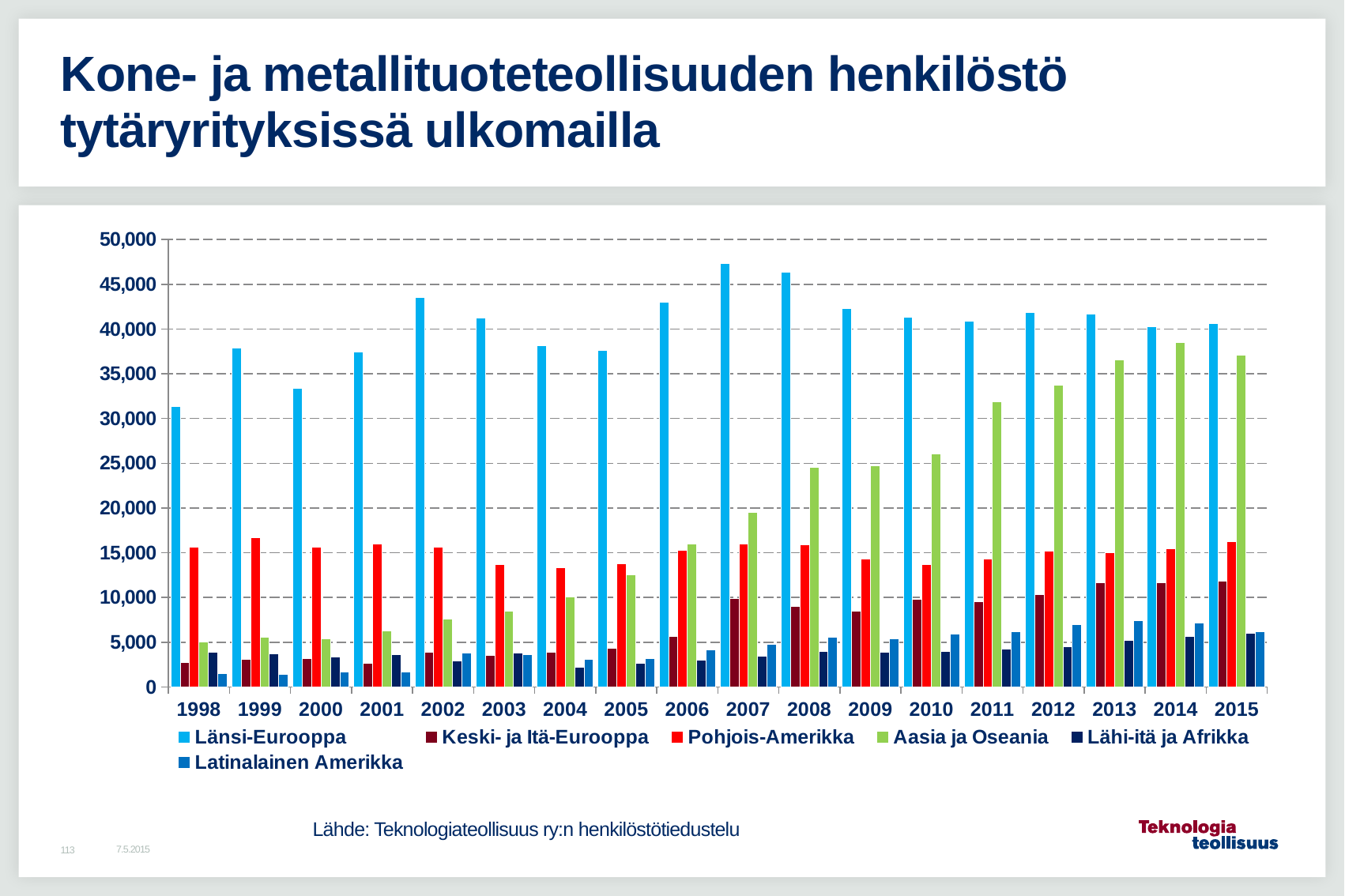
How many series does the legend list? 6 Is the value for Länsi-Eurooppa in 2007 greater or less than 45,000? greater In 2015, which is larger: Länsi-Eurooppa or Aasia ja Oseania? Länsi-Eurooppa In which year is the value for Länsi-Eurooppa highest? 2007 In which year is the value for Länsi-Eurooppa lowest? 1998 Does the value for Aasia ja Oseania generally rise or fall from 1998 to 2014? rise What kind of chart is shown on the slide? bar chart In which year is the value for Aasia ja Oseania highest? 2014 Is the value for Keski- ja Itä-Eurooppa in 2013 greater or less than 10,000? greater How many years are shown on the x axis? 18 Is the value for Aasia ja Oseania in 1998 greater or less than 10,000? less In 2014, which is larger: Aasia ja Oseania or Pohjois-Amerikka? Aasia ja Oseania